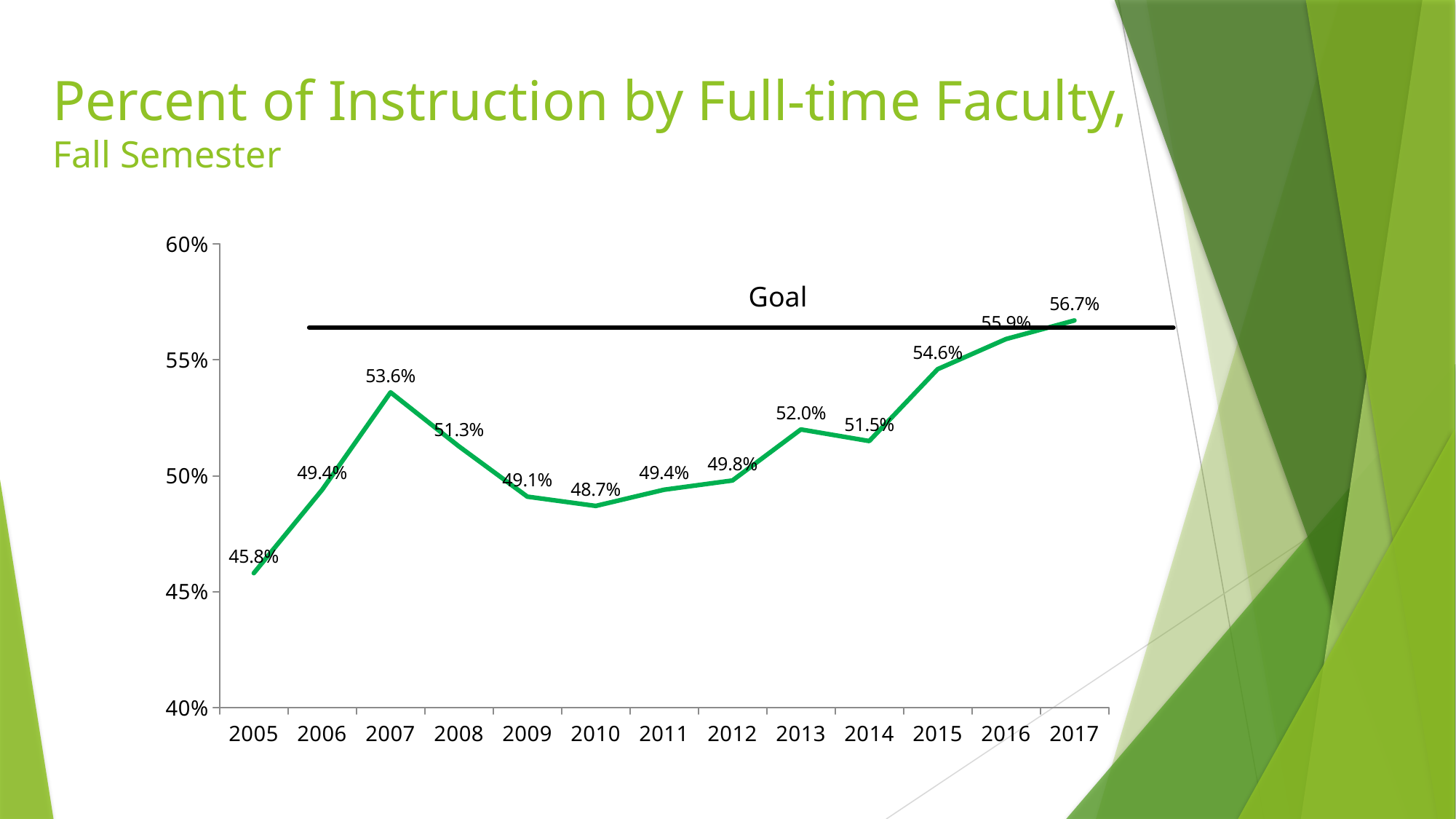
What is the percent of instruction by full-time faculty in 2010? 48.7% What is the percent of instruction by full-time faculty in 2015? 54.6% Do the values rise or fall from 2014 to 2017? rise Which year has the lowest percent of instruction by full-time faculty? 2005 What is the percent of instruction by full-time faculty in 2005? 45.8% How many years are plotted on the x axis? 13 What is the difference between the 2017 value and the 2005 value? 10.9% Is the value for 2016 greater or less than 55%? greater What type of chart is shown on the slide? line chart What is the label on the horizontal black line in the chart? Goal Which year has the highest percent of instruction by full-time faculty? 2017 Which year has a higher value, 2007 or 2013? 2007